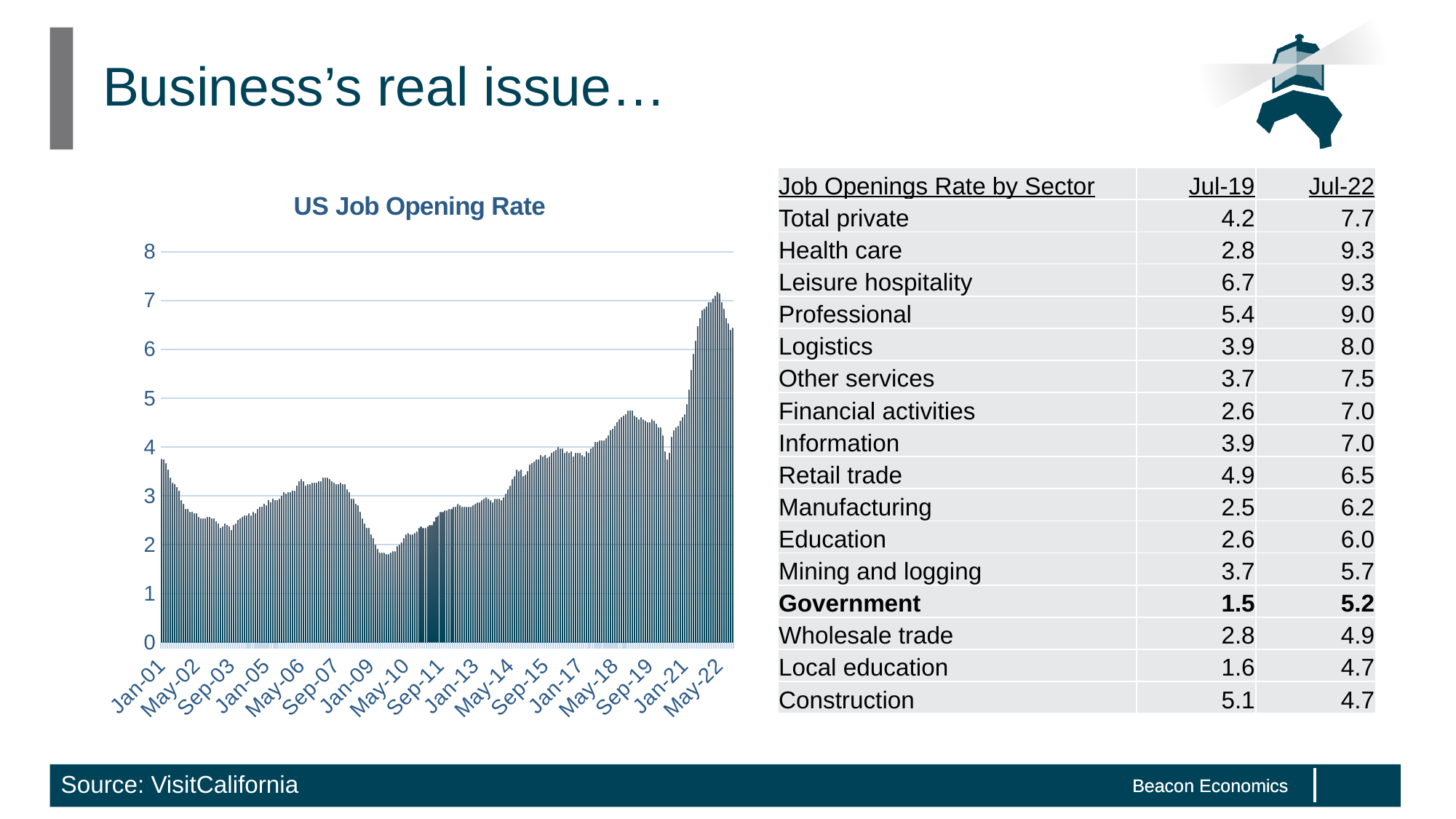
Is the highest value on the US Job Opening Rate chart greater or less than 6? greater What is the highest value shown on the chart's vertical axis? 8 Is the value for May-22 on the US Job Opening Rate chart greater or less than 6? greater What kind of chart is shown on the slide? bar chart Is the value for Jan-01 on the US Job Opening Rate chart greater or less than 3? greater Overall, does the US Job Opening Rate rise or fall from Jan-01 to May-22? rise Which is larger on the US Job Opening Rate chart, the value at Jan-01 or the value at May-22? May-22 What is the title of the chart on the slide? US Job Opening Rate Between which two x-axis labels does the US Job Opening Rate reach its peak? Jan-21 and May-22 Does the US Job Opening Rate rise or fall between Sep-07 and Jan-09? fall